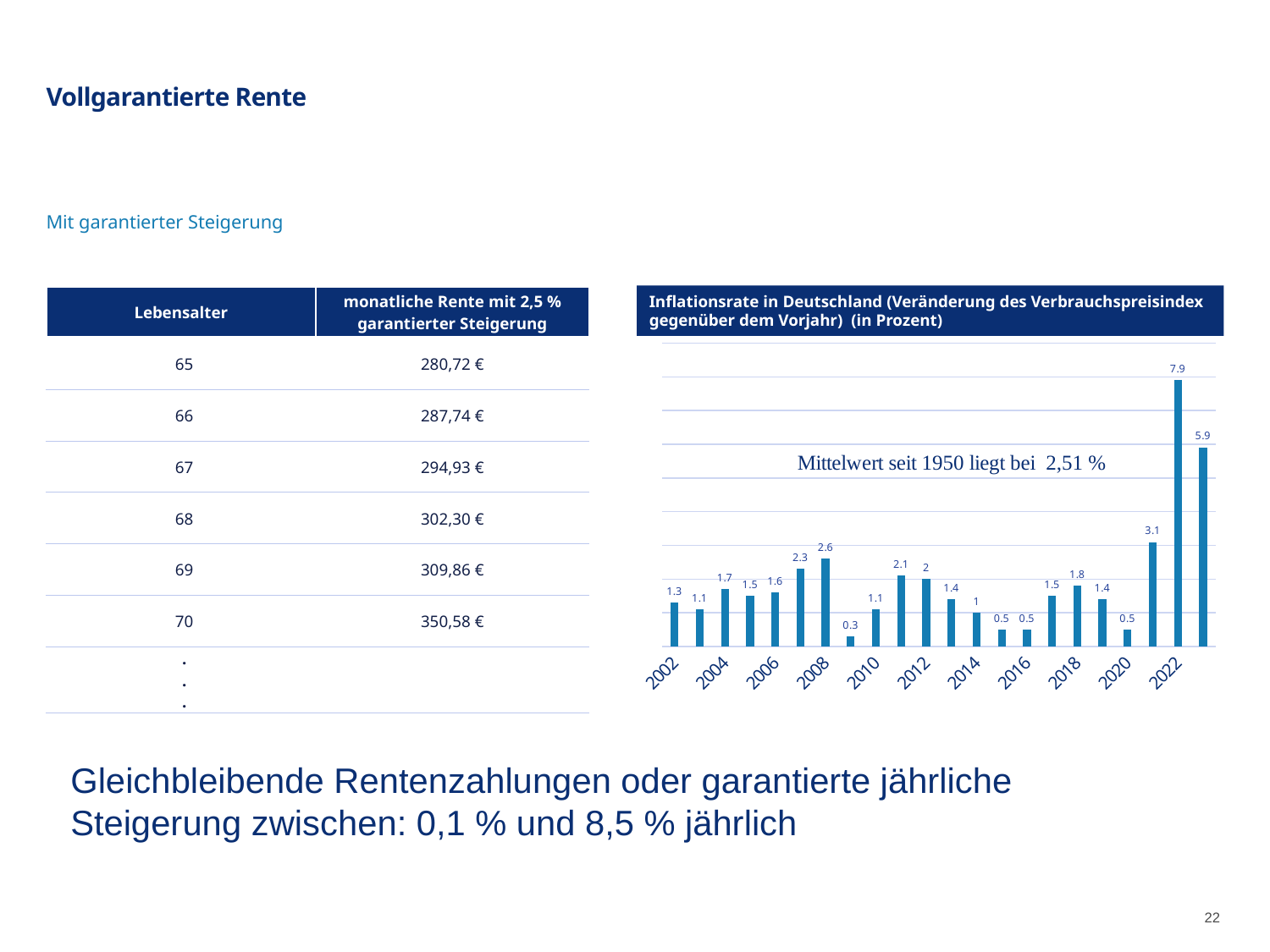
What type of chart is used to show the inflation rate in Germany? Bar chart Which year has the lowest inflation rate in the chart? 2009 What is the inflation rate shown for 2020? 0.5 Which year has the highest inflation rate in the chart? 2022 What is the inflation rate shown for 2008? 2.6 Does the inflation rate rise or fall from 2020 to 2022? Rise Which year has the higher inflation rate, 2008 or 2012? 2008 What is the difference between the inflation rate in 2022 and in 2020? 7.4 How many bars (years) are plotted in the inflation chart? 22 What is the inflation rate shown for 2002? 1.3 What is the inflation rate shown for 2022? 7.9 According to the text in the chart, what is the average inflation rate since 1950? 2,51 %